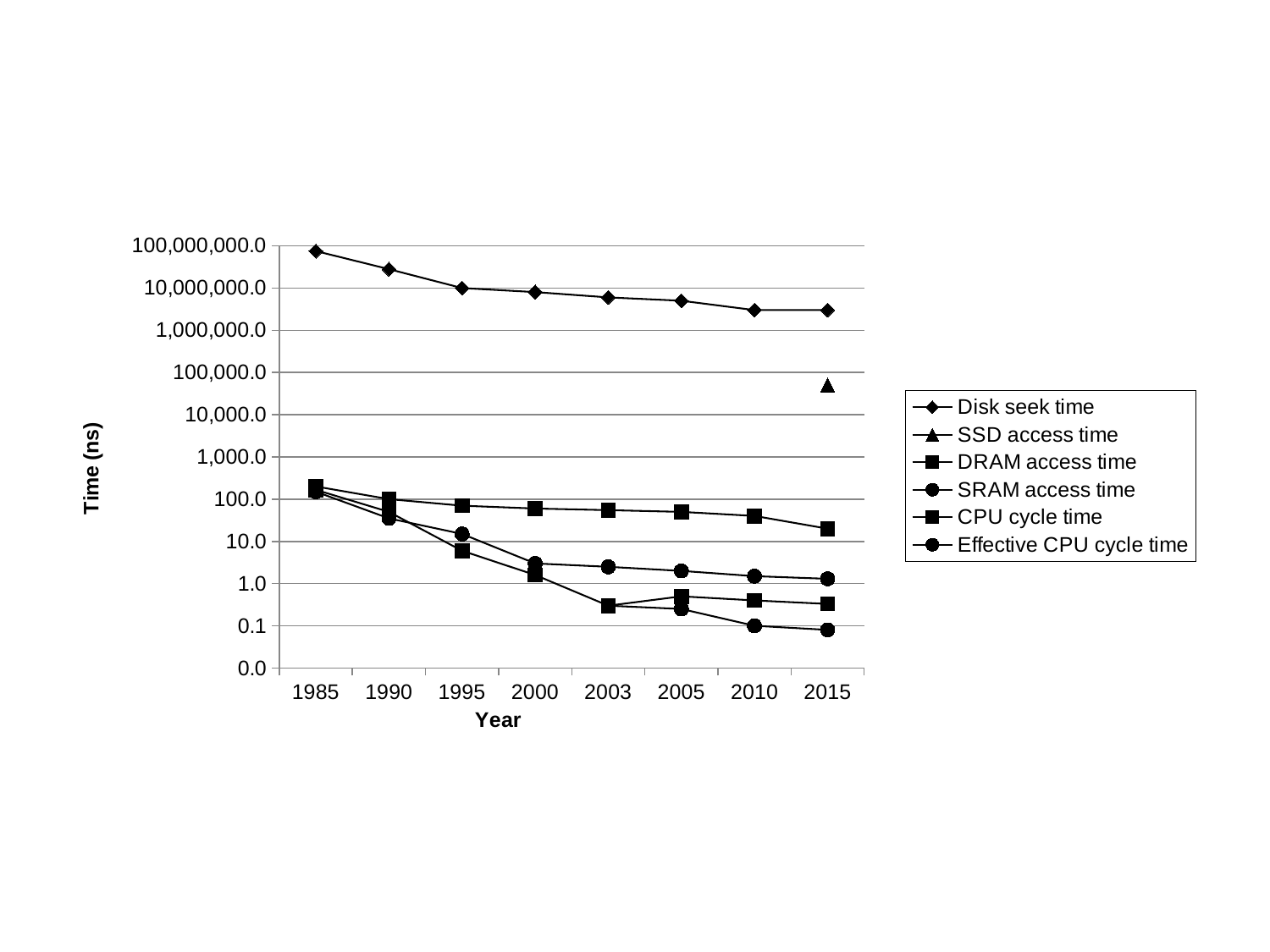
Is the value for SSD access time in 2015 greater or less than 10,000.0? greater How many years are shown on the x axis? 8 How many series does the legend list? 6 Is the value for Disk seek time in 1985 greater or less than 10,000,000.0? greater Which is larger in 2015, Disk seek time or SSD access time? Disk seek time Which series has the highest values across the chart? Disk seek time What is the title of the y axis? Time (ns) Is the value for Effective CPU cycle time in 2015 greater or less than 1.0? less Does Disk seek time rise or fall from 1985 to 2015? fall What kind of chart is shown on the slide? line chart